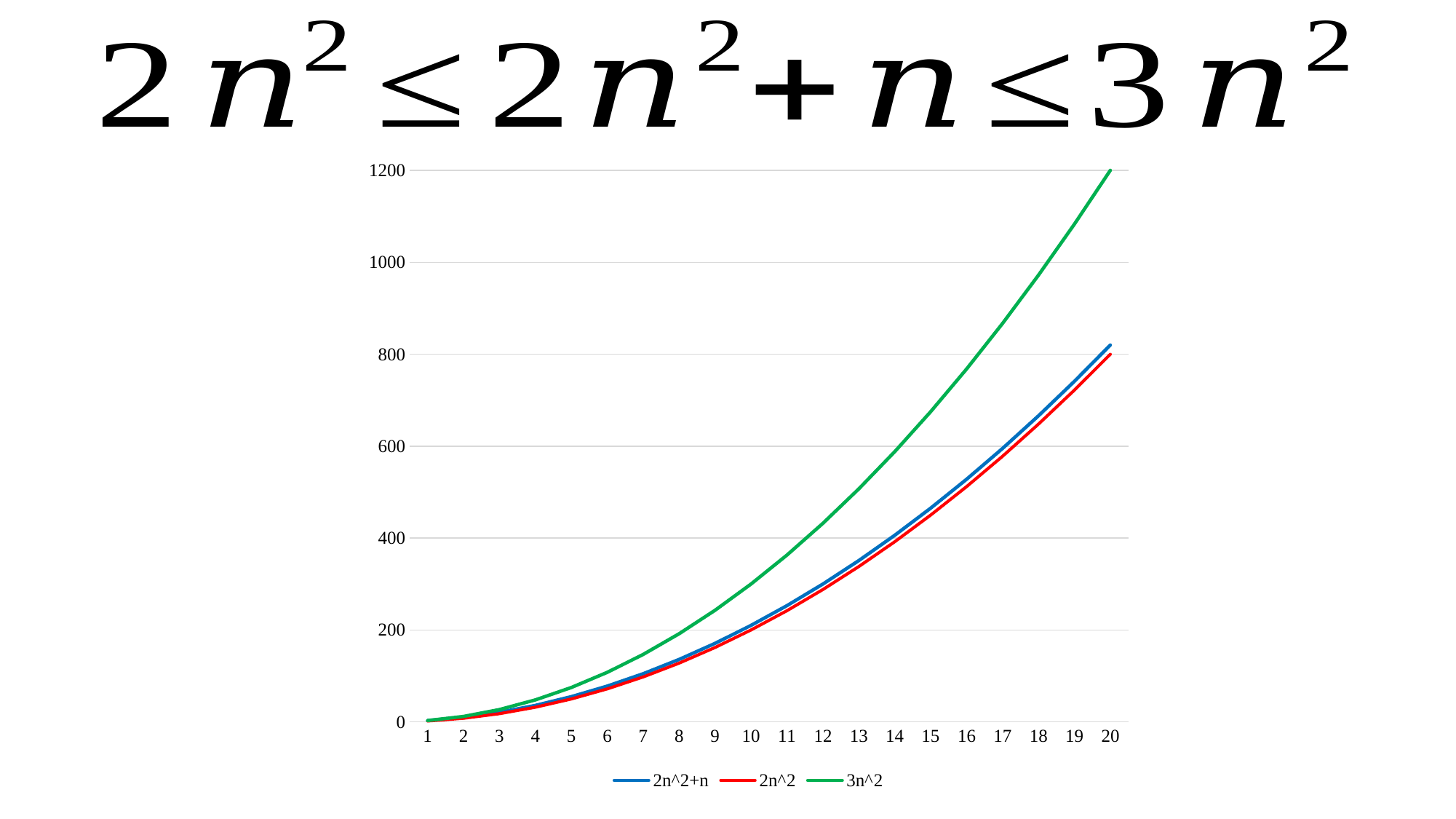
How many series does the chart's legend list? 3 Is the value of the 3n^2 series at n = 15 greater or less than 600? greater What colour is the line for the 3n^2 series? green At n = 20, which is larger: the 3n^2 series or the 2n^2 series? 3n^2 What is the value of the 2n^2 series at n = 20? 800 What is the value of the 3n^2 series at n = 20? 1200 Do the values of the 3n^2 series rise or fall as n increases from 1 to 20? rise How many points along the x axis does each line in the chart have? 20 What kind of chart is shown on the slide? line chart Which series has the highest value at n = 20? 3n^2 Is the value of the 2n^2+n series at n = 10 greater or less than 400? less What is the difference between the 3n^2 and 2n^2 series at n = 20? 400